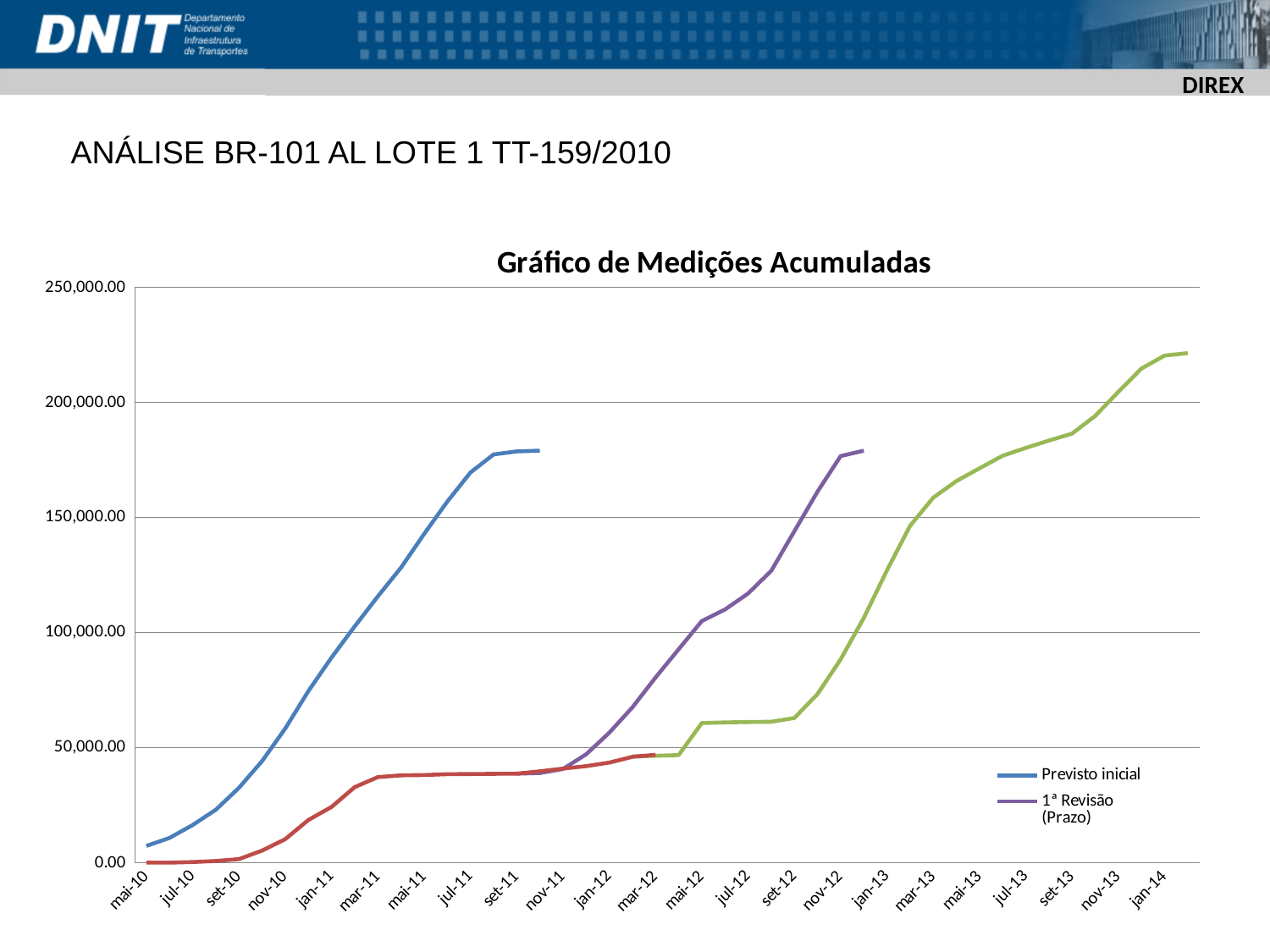
What type of chart is shown on the slide? line chart How many series does the chart legend list? 2 Is the value of 'Previsto inicial' at mai-11 greater or less than 100,000.00? greater What is the highest value shown on the y axis? 250,000.00 How many month labels are shown along the x axis? 23 What is the title of the chart? Gráfico de Medições Acumuladas What colour is the 'Previsto inicial' line in the chart? blue Is the value of 'Previsto inicial' at jul-10 greater or less than 50,000.00? less Is the value of 'Previsto inicial' at set-11 greater or less than 150,000.00? greater Does the 'Previsto inicial' line rise or fall from mai-10 to set-11? rise